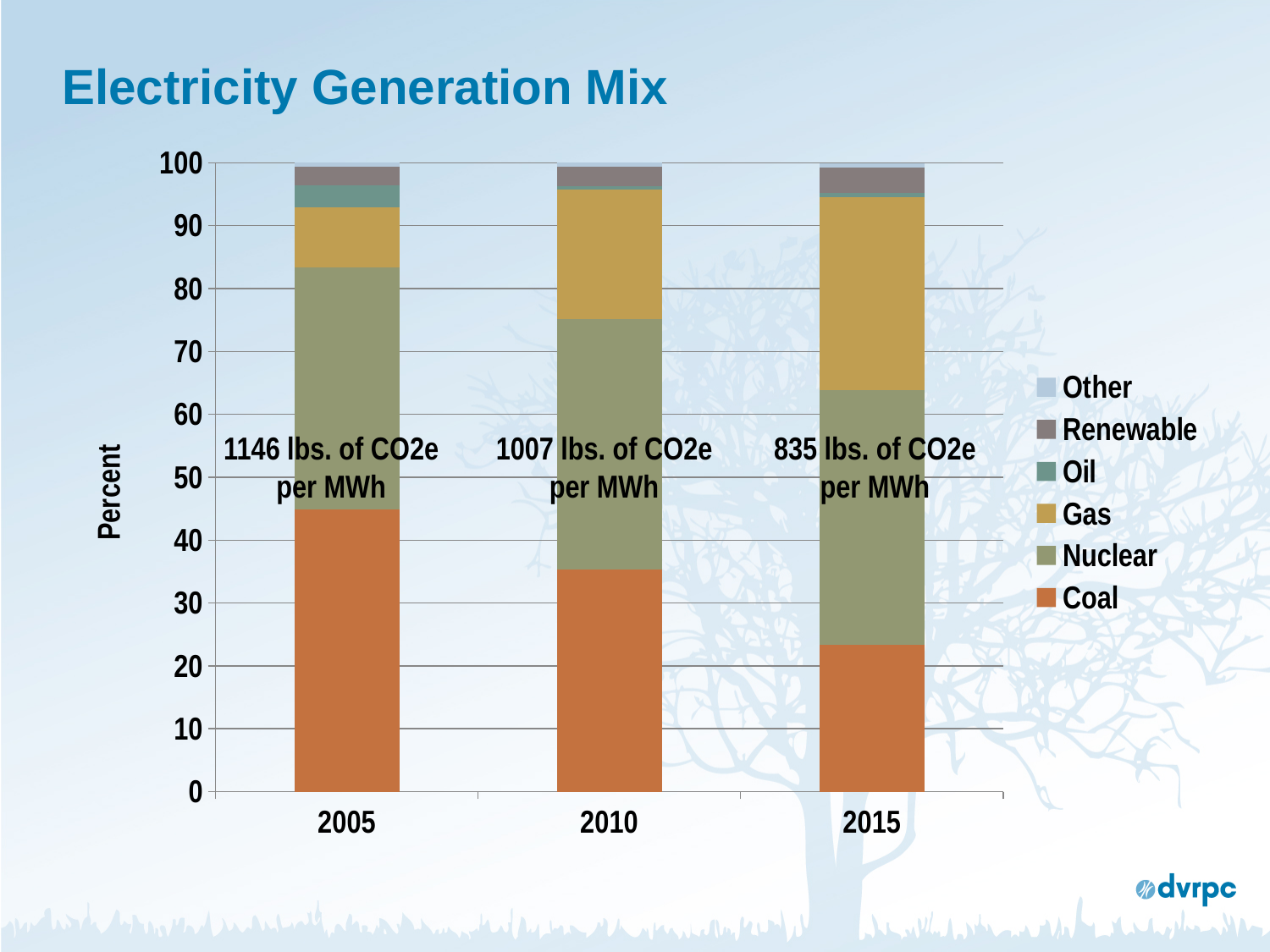
How many years are shown on the x axis of the chart? 3 What is the CO2e emission rate noted for 2005? 1146 lbs. of CO2e per MWh Is the Coal share in 2015 greater or less than 30 percent? less Which year has the largest Coal share? 2005 By how many lbs. of CO2e per MWh did the noted emission rate fall from 2005 to 2015? 311 What kind of chart is shown on the slide? Stacked bar chart What is the title of the chart? Electricity Generation Mix What is the CO2e emission rate noted for 2015? 835 lbs. of CO2e per MWh Is the Coal share in 2005 greater or less than 40 percent? greater Does the Coal share rise or fall from 2005 to 2015? Fall Which year has the smallest Coal share? 2015 How many series does the legend list? 6